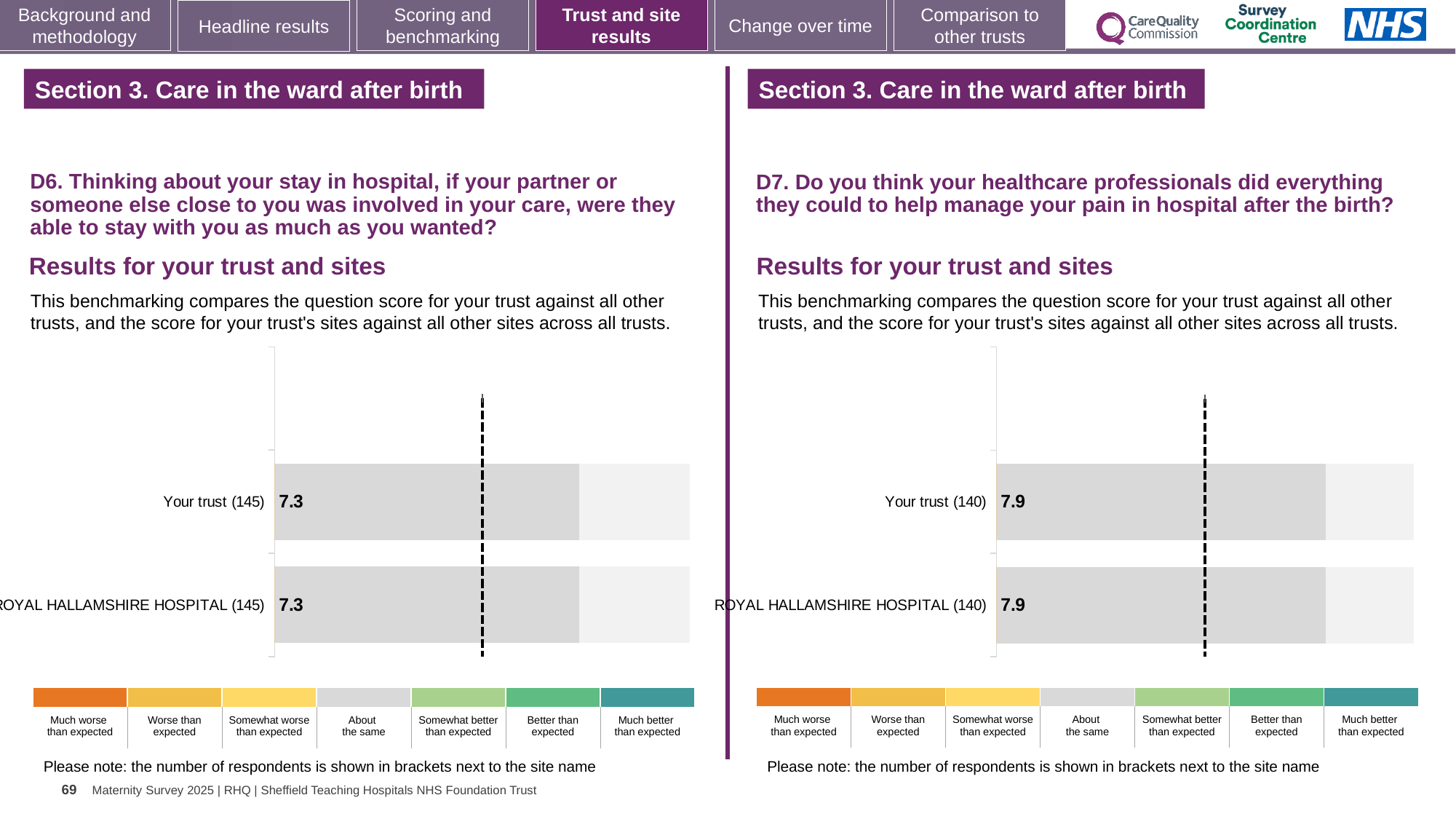
On the D7 chart (right), what is the score for ROYAL HALLAMSHIRE HOSPITAL? 7.9 On the D6 chart (left), what is the score for Your trust? 7.3 How many categories does the colour key below the D7 chart (right) list? 7 What is the difference between the Your trust score on the D7 chart (right) and the Your trust score on the D6 chart (left)? 0.6 On the D7 chart (right), what is the score for Your trust? 7.9 What kind of chart is used on the D6 chart (left)? Bar chart Which is larger: the Your trust score on the D6 chart (left) or the Your trust score on the D7 chart (right)? D7 chart (right) On the D7 chart (right), how many respondents are shown in brackets for ROYAL HALLAMSHIRE HOSPITAL? 140 How many bars are plotted on the D7 chart (right)? 2 On the D6 chart (left), what is the score for ROYAL HALLAMSHIRE HOSPITAL? 7.3 How many bars are plotted on the D6 chart (left)? 2 On the D6 chart (left), how many respondents are shown in brackets for Your trust? 145